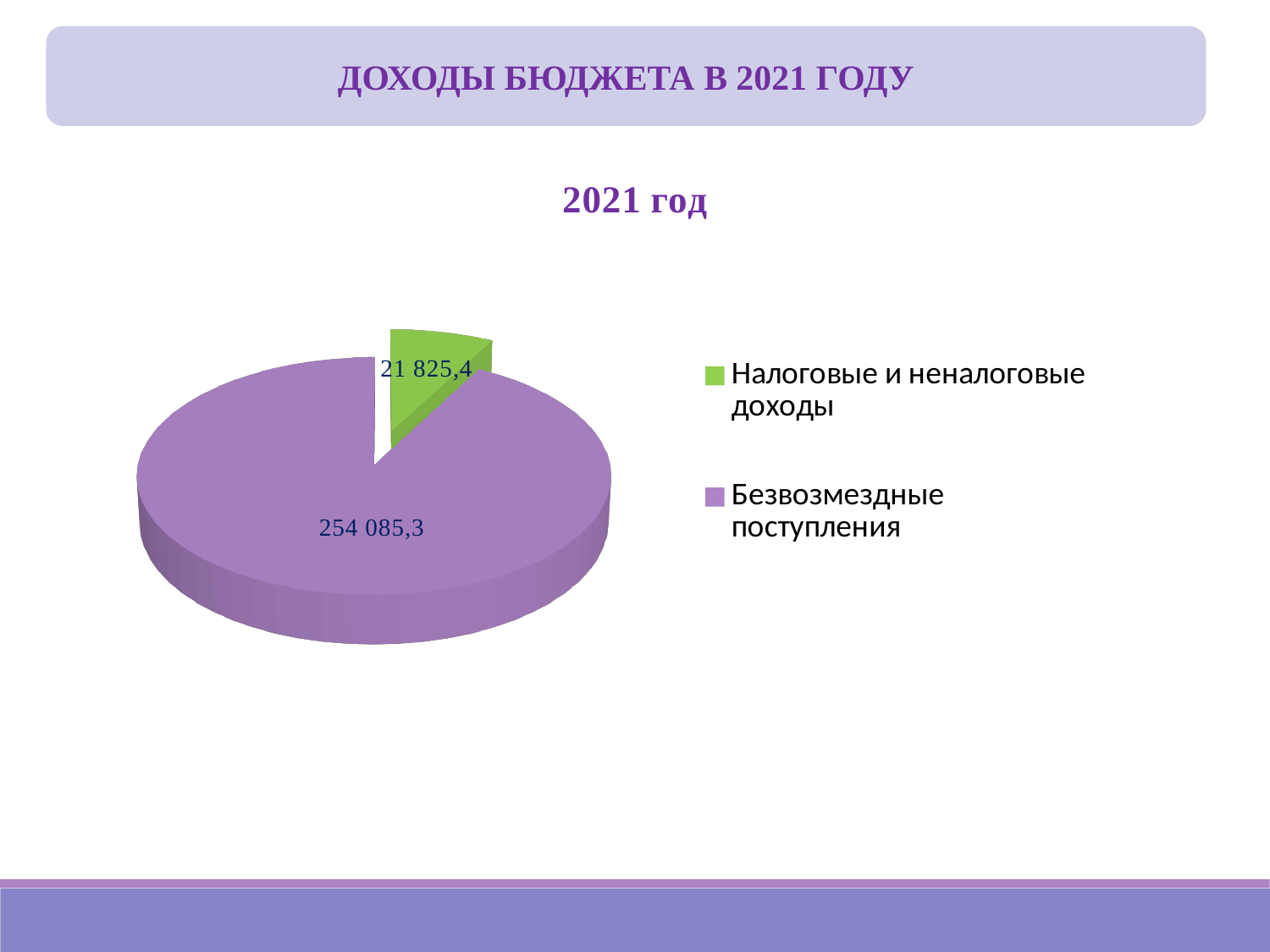
What is the value for Налоговые и неналоговые доходы? 21 825,4 What is the title shown above the pie chart? 2021 год What is the total of the two slices in the pie chart? 275 910,7 What colour is the slice for Налоговые и неналоговые доходы? green What is the value for Безвозмездные поступления? 254 085,3 Which category has the largest slice of the pie? Безвозмездные поступления Which category has the smallest slice of the pie? Налоговые и неналоговые доходы What is the difference between Безвозмездные поступления and Налоговые и неналоговые доходы? 232 259,9 Which is larger: Налоговые и неналоговые доходы or Безвозмездные поступления? Безвозмездные поступления How many entries does the legend list? 2 How many slices does the pie chart have? 2 What type of chart is shown on the slide? pie chart